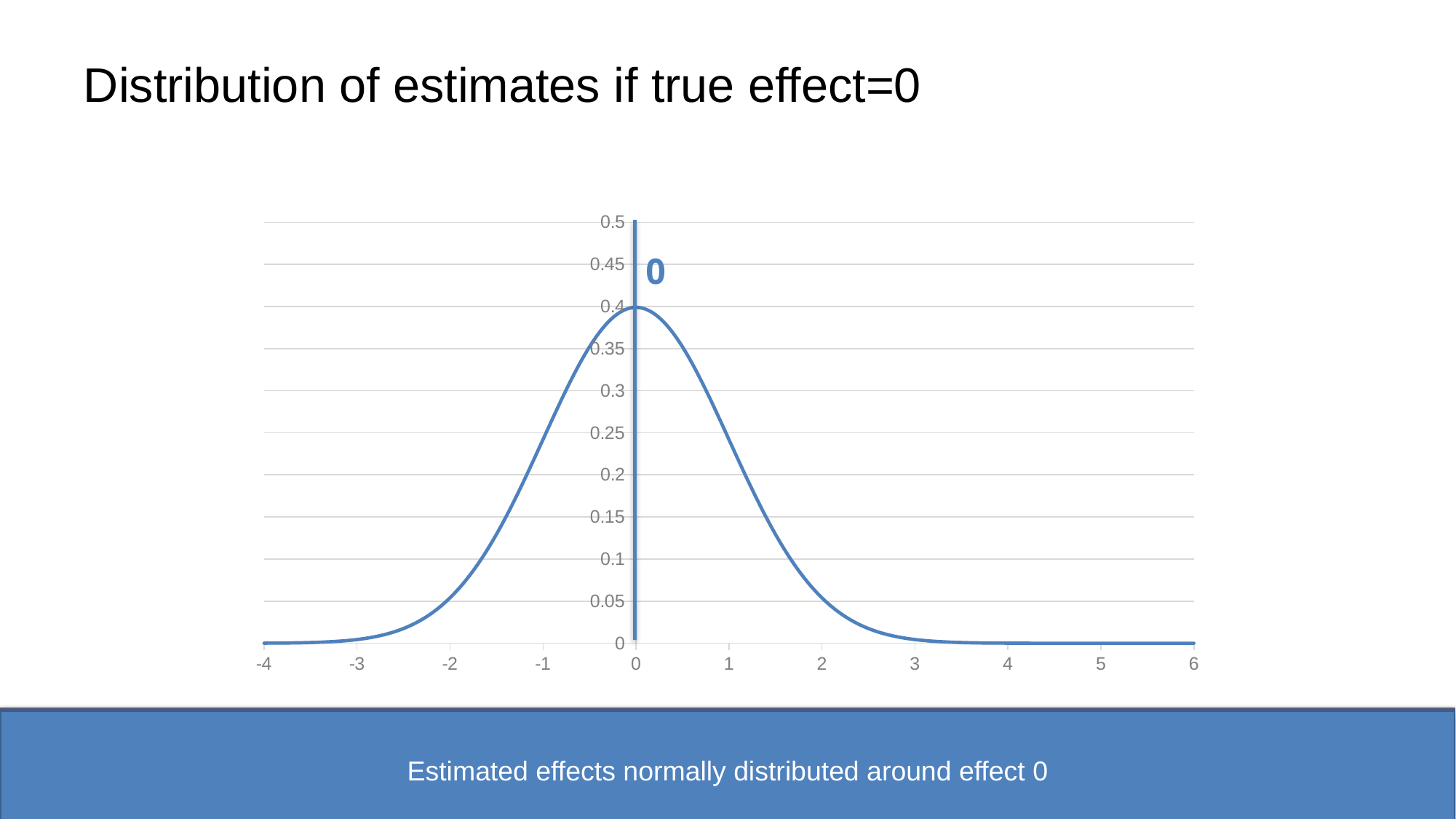
Is the value of the curve at x = 1 greater or less than 0.2? greater Is the value of the curve at x = 0 greater or less than 0.35? greater Is the value of the curve at x = -1 greater or less than 0.3? less Does the curve rise or fall as x increases from 0 to 3? fall At which x-axis value does the curve reach its highest point? 0 What is the title of the chart on the slide? Distribution of estimates if true effect=0 What kind of chart is shown on the slide? line chart Which has the larger value on the curve, x = 1 or x = 2? x = 1 What label is printed next to the vertical line at the centre of the chart? 0 Does the curve rise or fall as x increases from -4 to 0? rise